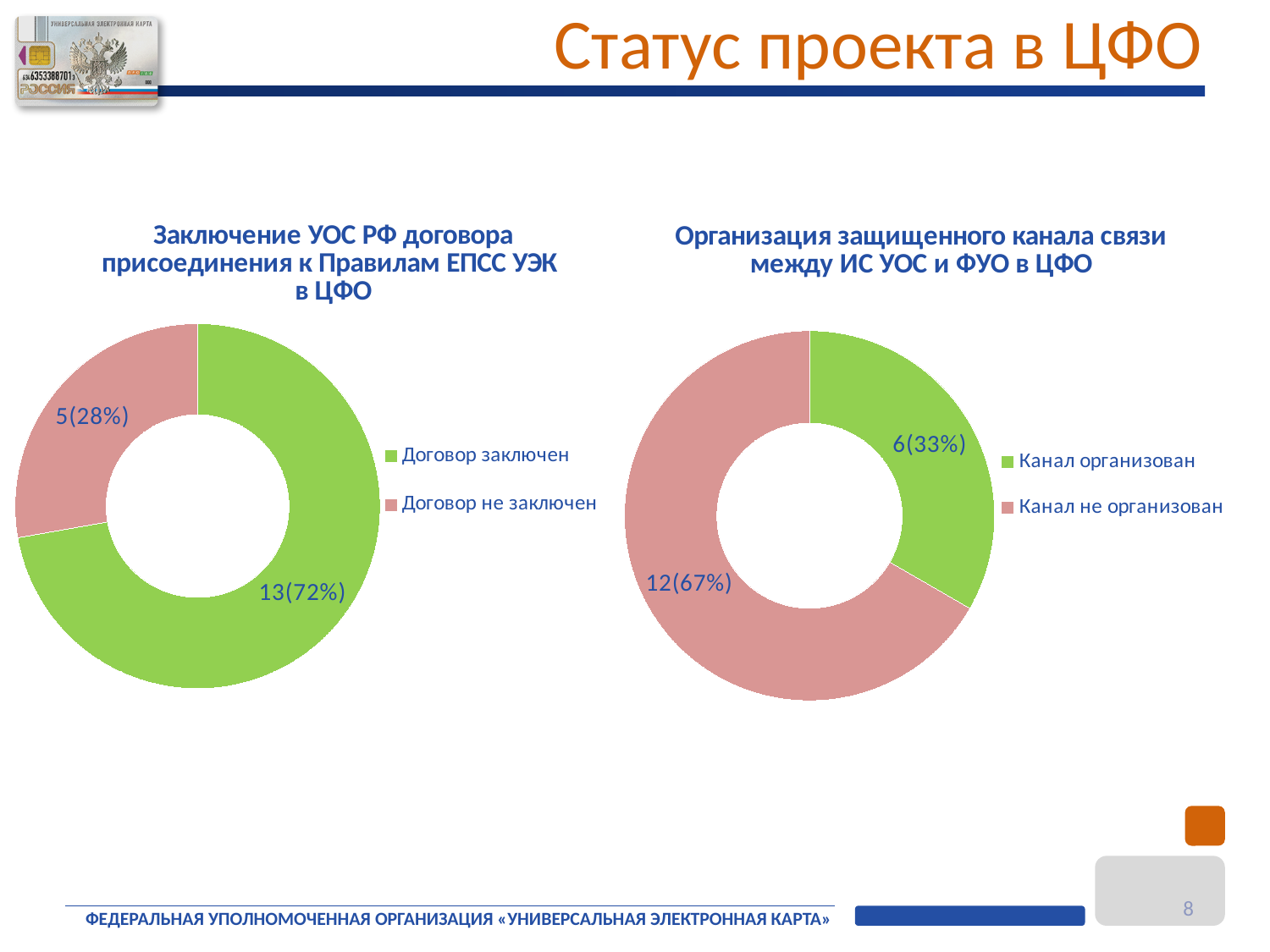
What type of chart is used on the right side of the slide? Doughnut (pie) chart In the left chart (Заключение УОС РФ договора присоединения к Правилам ЕПСС УЭК в ЦФО), what is the value for 'Договор не заключен'? 5(28%) In the right chart, which category has the smallest share? Канал организован In the right chart, what is the difference in count between 'Канал не организован' and 'Канал организован'? 6 In the left chart, what is the difference in count between 'Договор заключен' and 'Договор не заключен'? 8 In the left chart (Заключение УОС РФ договора присоединения к Правилам ЕПСС УЭК в ЦФО), what is the value for 'Договор заключен'? 13(72%) In the right chart, which is larger: 'Канал организован' or 'Канал не организован'? Канал не организован What share of the left chart does 'Договор не заключен' represent? 28% In the right chart (Организация защищенного канала связи между ИС УОС и ФУО в ЦФО), what is the value for 'Канал организован'? 6(33%) In the right chart (Организация защищенного канала связи между ИС УОС и ФУО в ЦФО), what is the value for 'Канал не организован'? 12(67%) In the left chart, which category has the largest share? Договор заключен How many entries does the legend of the left chart list? 2